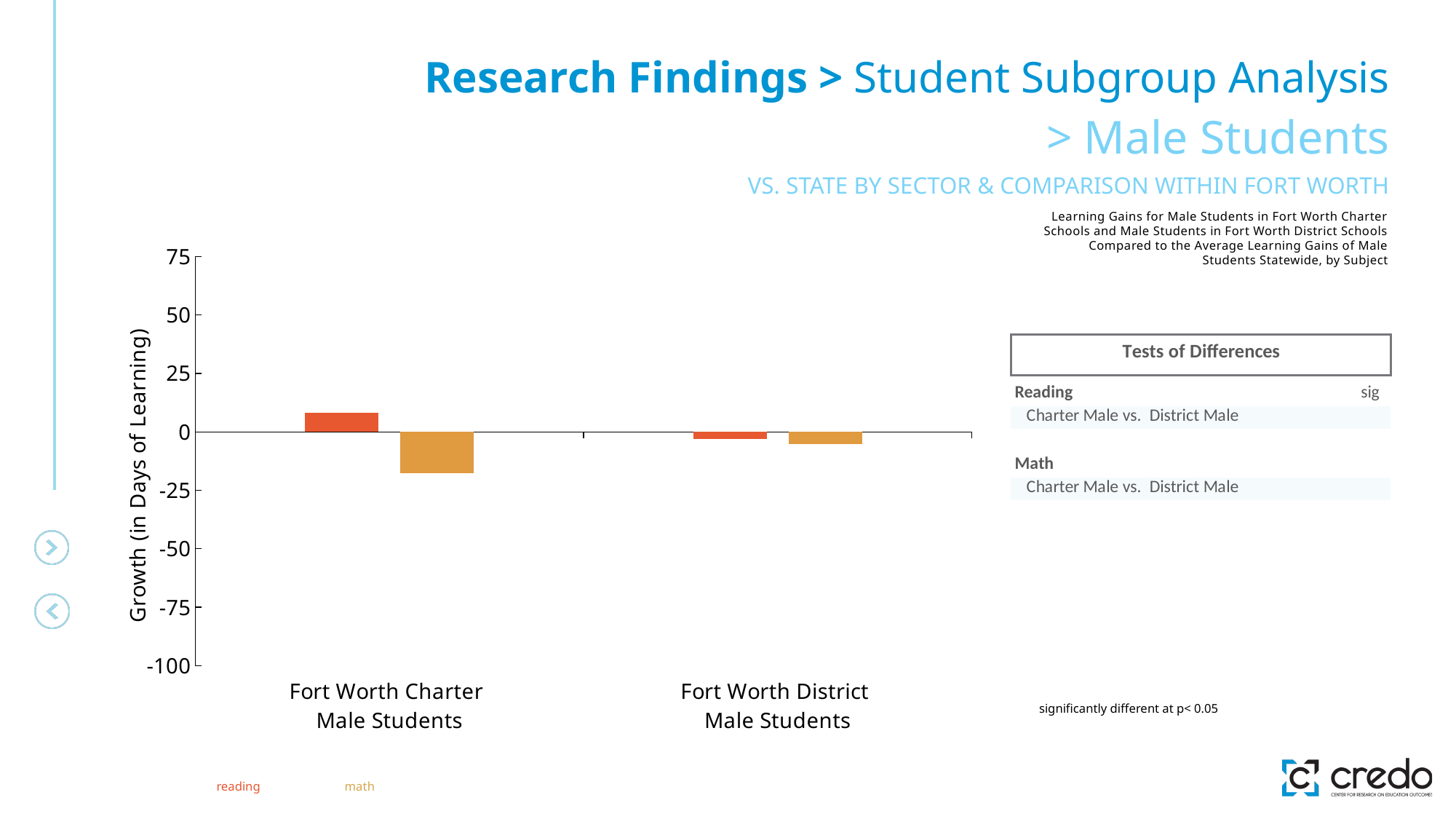
Which bar shows the lowest growth in days of learning? math for Fort Worth Charter Male Students What kind of chart is shown on the slide? bar chart Is the math value for Fort Worth Charter Male Students greater or less than -25? greater What is the label of the vertical axis? Growth (in Days of Learning) Which bar shows the highest growth in days of learning? reading for Fort Worth Charter Male Students How many series does the legend list? 2 Is the reading value for Fort Worth District Male Students greater or less than 0? less Is the reading value for Fort Worth Charter Male Students greater or less than 0? greater Which group has the higher reading value, Fort Worth Charter Male Students or Fort Worth District Male Students? Fort Worth Charter Male Students Which two series are listed in the legend? reading and math How many student groups (categories) are shown on the x axis? 2